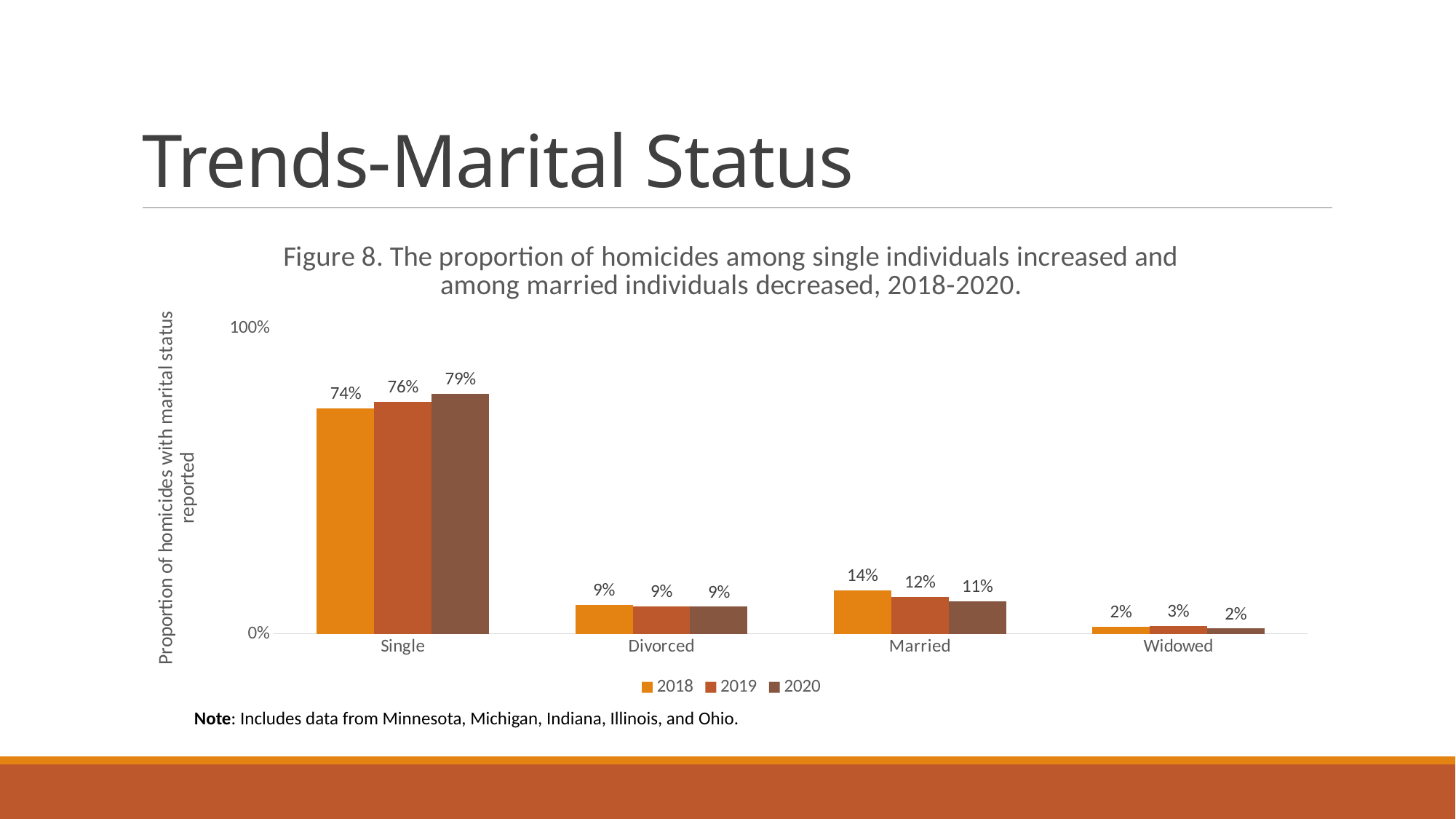
How many marital status categories are shown on the x axis? 4 What is the value for Widowed in 2019? 3% What is the value for Married in 2018? 14% Do the values for Married rise or fall from 2018 to 2020? Fall What is the difference between the Single values for 2020 and 2018? 5% How many series does the legend list? 3 Which marital status category has the lowest value in 2020? Widowed What kind of chart is shown on the slide? Bar chart Which marital status category has the highest value in 2018? Single Which is larger, the Married value in 2018 or the Married value in 2020? Married in 2018 What is the value for Divorced in 2019? 9% What is the value for Single in 2020? 79%